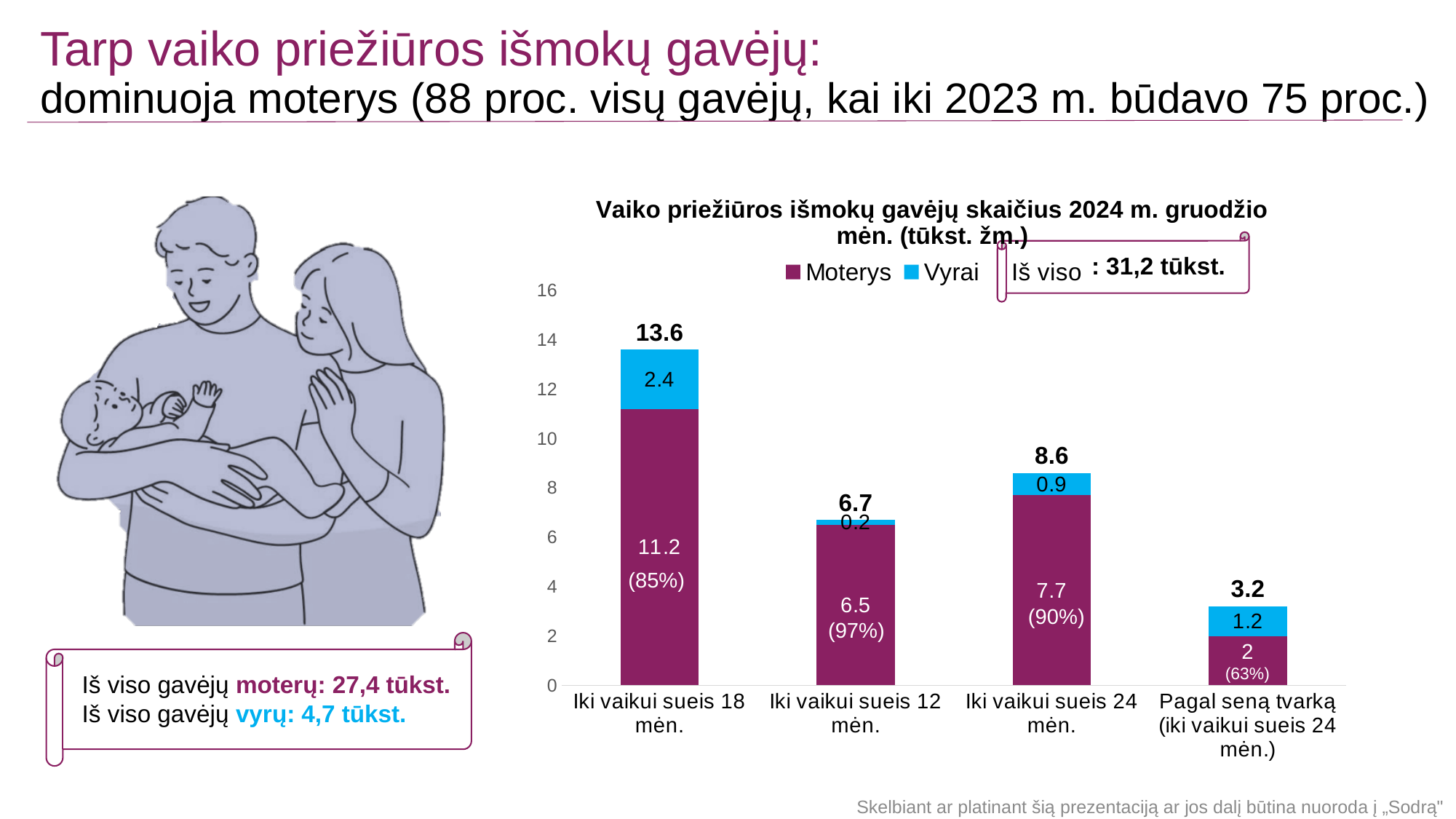
Is the total for "Iki vaikui sueis 12 mėn." greater or less than 8? less What is the total of the stacked bar for "Pagal seną tvarką (iki vaikui sueis 24 mėn.)"? 3.2 Which category has the highest total value? Iki vaikui sueis 18 mėn. Which is larger: the Vyrai value for "Iki vaikui sueis 18 mėn." or the Vyrai value for "Pagal seną tvarką (iki vaikui sueis 24 mėn.)"? Iki vaikui sueis 18 mėn. Which category has the lowest total value? Pagal seną tvarką (iki vaikui sueis 24 mėn.) What is the Vyrai value for "Iki vaikui sueis 24 mėn."? 0.9 What is the Moterys value for "Iki vaikui sueis 18 mėn."? 11.2 What is the Vyrai value for "Iki vaikui sueis 12 mėn."? 0.2 What is the difference between the total for "Iki vaikui sueis 18 mėn." and the total for "Iki vaikui sueis 24 mėn."? 5 How many categories are shown on the x axis? 4 What kind of chart is shown on the slide? stacked bar chart